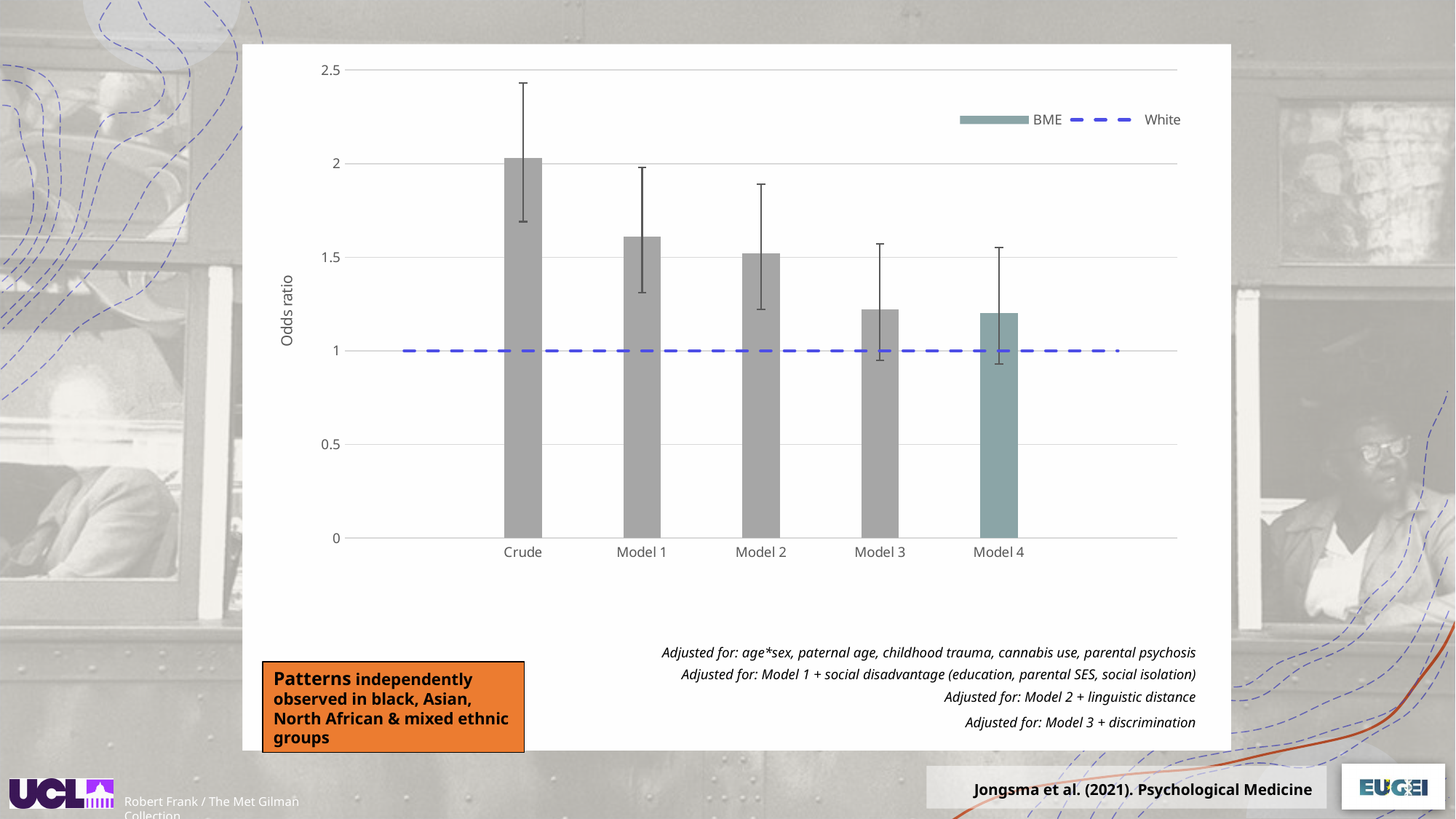
Which category has the highest odds ratio for BME? Crude Is the BME odds ratio for Model 4 greater or less than 1? greater Is the BME odds ratio for Model 3 greater or less than 1.5? less How many categories are shown on the x axis of the chart? 5 Which has the larger BME odds ratio, Crude or Model 1? Crude What kind of chart is shown on the slide? bar chart Which has the larger BME odds ratio, Model 2 or Model 4? Model 2 How many series does the chart's legend list? 2 What is the label on the y axis of the chart? Odds ratio What is the odds ratio shown by the dashed White reference line? 1 Is the BME odds ratio for Model 1 greater or less than 1.5? greater Do the BME odds ratios rise or fall from Crude to Model 4 along the x axis? fall